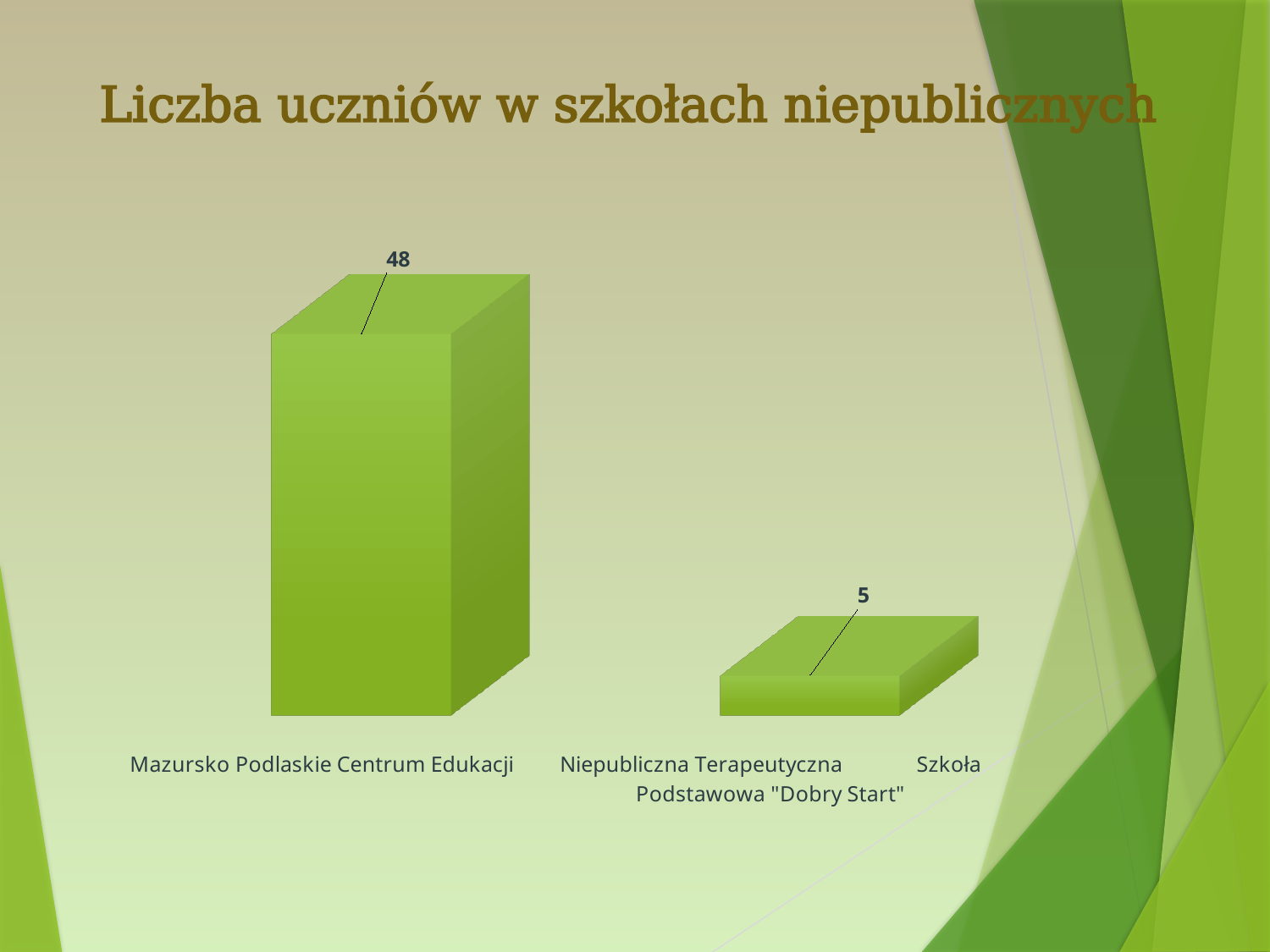
Which category has the lowest value? Niepubliczna Terapeutyczna Szkoła Podstawowa "Dobry Start" What colour are the bars in the chart? green What is the difference between the values for Mazursko Podlaskie Centrum Edukacji and Niepubliczna Terapeutyczna Szkoła Podstawowa "Dobry Start"? 43 Do the values rise or fall from left to right along the x axis? fall Which is larger: the value for Mazursko Podlaskie Centrum Edukacji or the value for Niepubliczna Terapeutyczna Szkoła Podstawowa "Dobry Start"? Mazursko Podlaskie Centrum Edukacji What kind of chart is shown on the slide? bar chart How many categories are shown in the chart? 2 What is the total of the two values shown in the chart? 53 What is the title of the slide? Liczba uczniów w szkołach niepublicznych What is the value for Niepubliczna Terapeutyczna Szkoła Podstawowa "Dobry Start"? 5 Which category has the highest value? Mazursko Podlaskie Centrum Edukacji What is the value for Mazursko Podlaskie Centrum Edukacji? 48